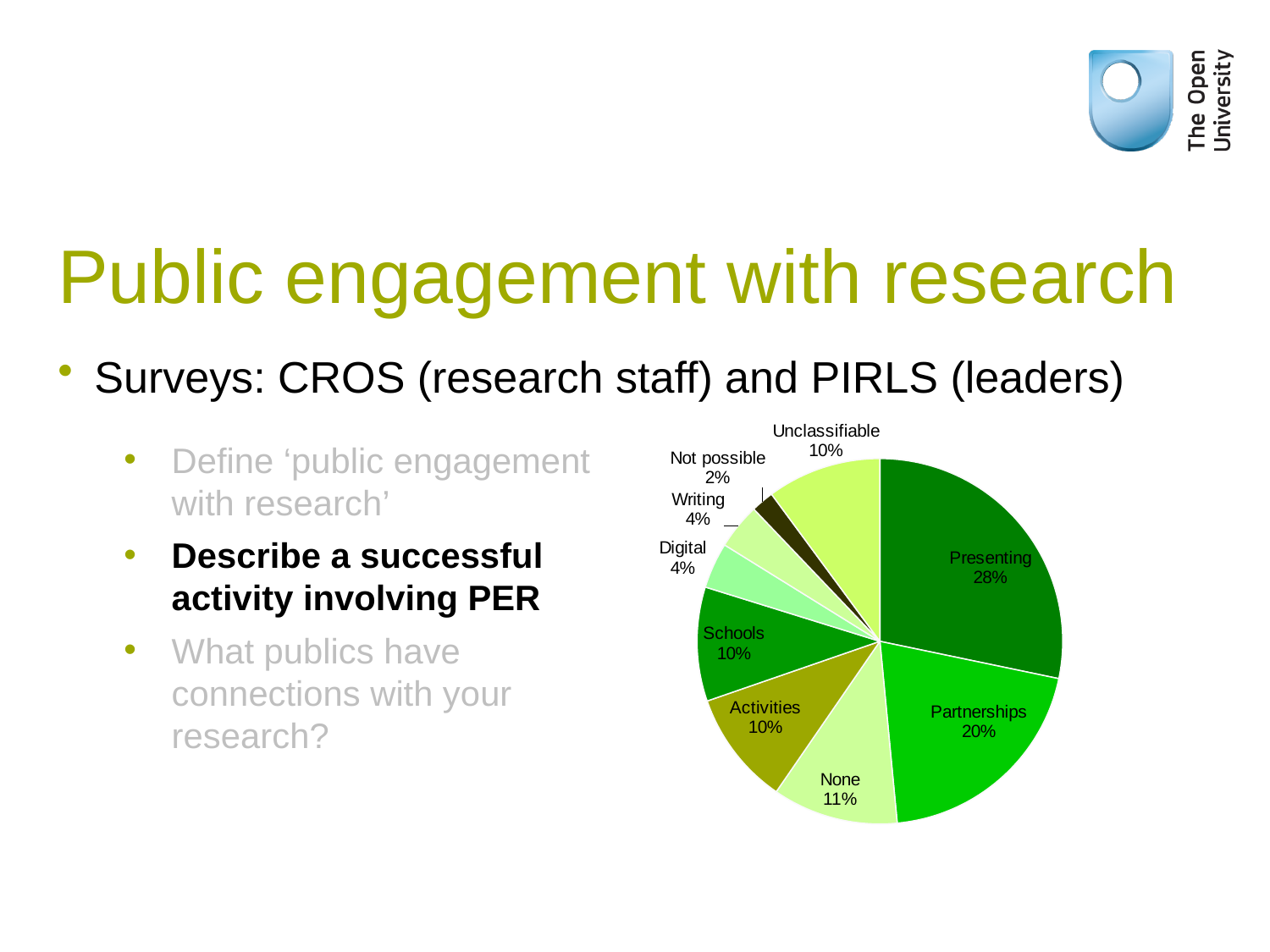
What share of the pie does Presenting account for? 28% Which category has the largest slice of the pie? Presenting Which category has the smallest slice of the pie? Not possible What percentage is shown for the None slice? 11% What is the value shown for Not possible? 2% What is the value shown for Partnerships? 20% What is the difference in percentage points between Presenting and Partnerships? 8 What is the combined share of Writing and Digital? 8% How many slices does the pie chart have? 9 Which is larger, the share for Schools or the share for Digital? Schools What kind of chart is shown on the slide? pie chart